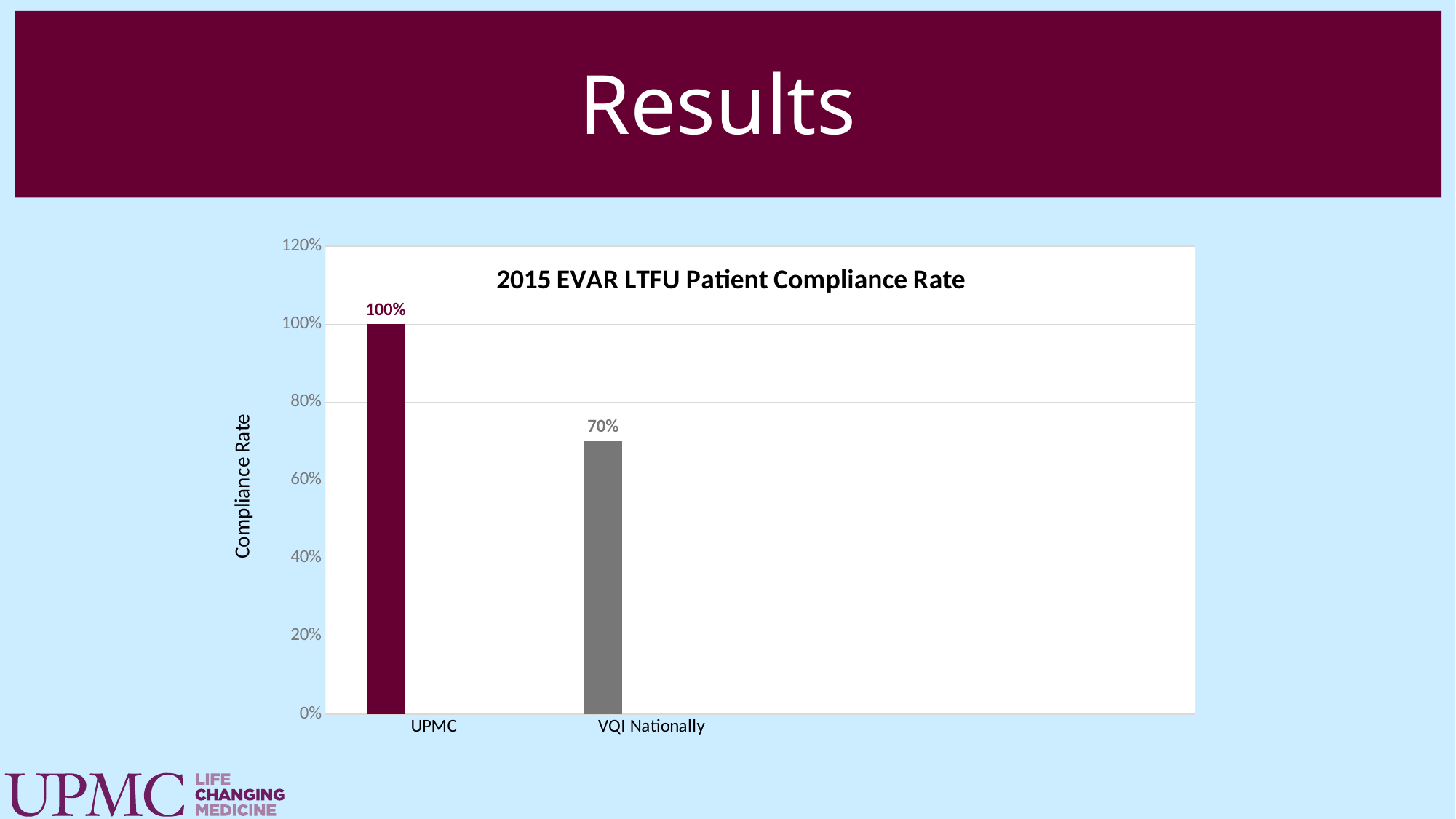
What is the compliance rate for UPMC? 100% What is the difference between the UPMC and VQI Nationally compliance rates? 30% What kind of chart is shown on the slide? Bar chart What is the title of the chart? 2015 EVAR LTFU Patient Compliance Rate How many categories are shown in the chart? 2 Which category has the highest compliance rate? UPMC Which category has the lowest compliance rate? VQI Nationally What is the label of the vertical axis? Compliance Rate Is the value for VQI Nationally greater or less than 80%? less Which is larger, the compliance rate for UPMC or for VQI Nationally? UPMC What is the compliance rate for VQI Nationally? 70%